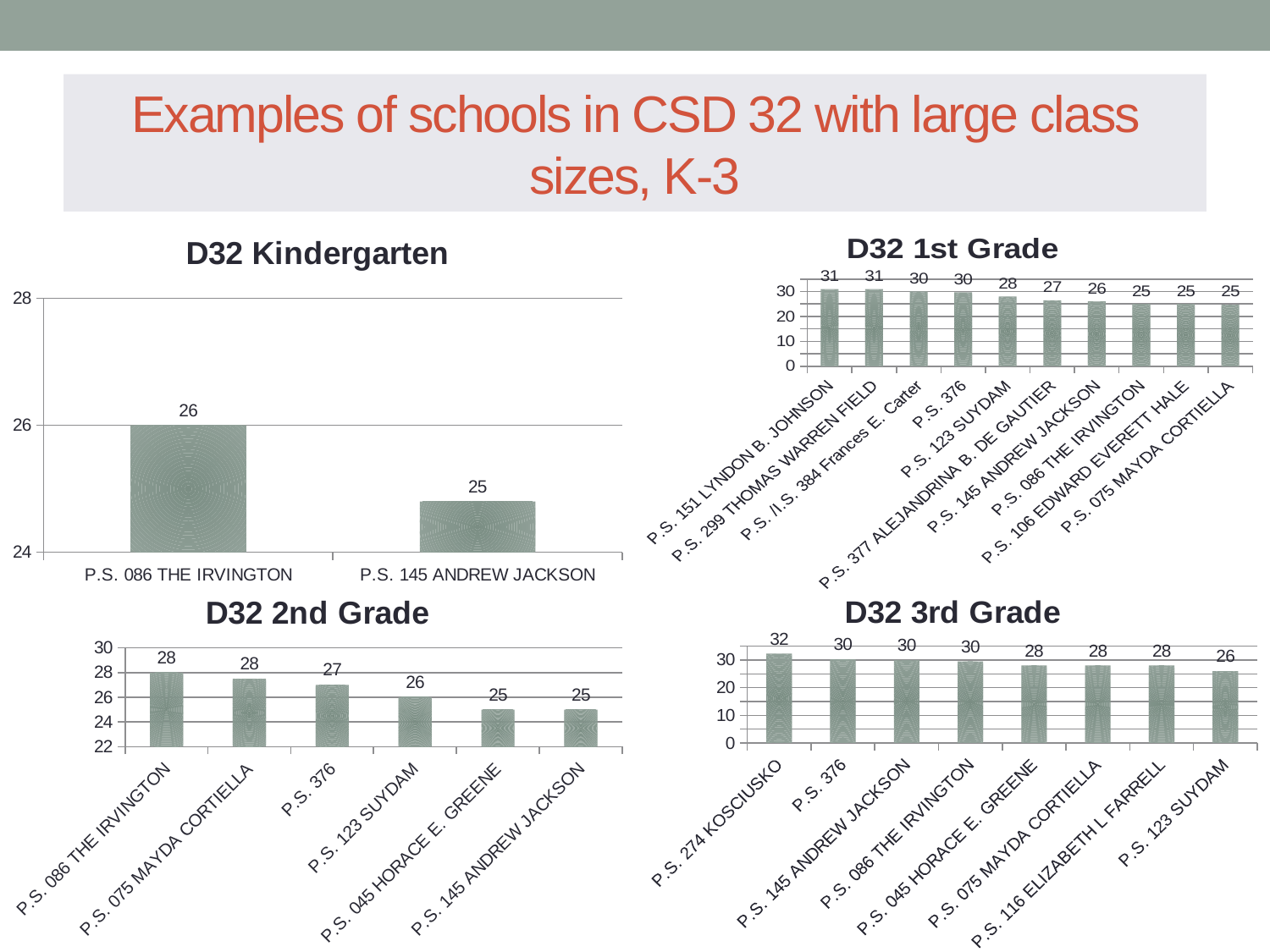
What type of chart is the D32 3rd Grade chart? bar chart In the D32 2nd Grade chart, what is the value for P.S. 376? 27 In the D32 1st Grade chart, what is the difference between P.S. 151 LYNDON B. JOHNSON and P.S. 075 MAYDA CORTIELLA? 6 How many schools are shown in the D32 1st Grade chart? 10 In the D32 2nd Grade chart, do the values rise or fall from left to right? fall In the D32 Kindergarten chart, what is the value for P.S. 086 THE IRVINGTON? 26 How many schools are shown in the D32 Kindergarten chart? 2 In the D32 1st Grade chart, which school has the lowest value among P.S. 151 LYNDON B. JOHNSON and P.S. 145 ANDREW JACKSON? P.S. 145 ANDREW JACKSON In the D32 3rd Grade chart, which school has the lowest value? P.S. 123 SUYDAM In the D32 3rd Grade chart, what is the difference between P.S. 274 KOSCIUSKO and P.S. 045 HORACE E. GREENE? 4 In the D32 3rd Grade chart, which school has the highest value? P.S. 274 KOSCIUSKO In the D32 1st Grade chart, what is the value for P.S. 123 SUYDAM? 28